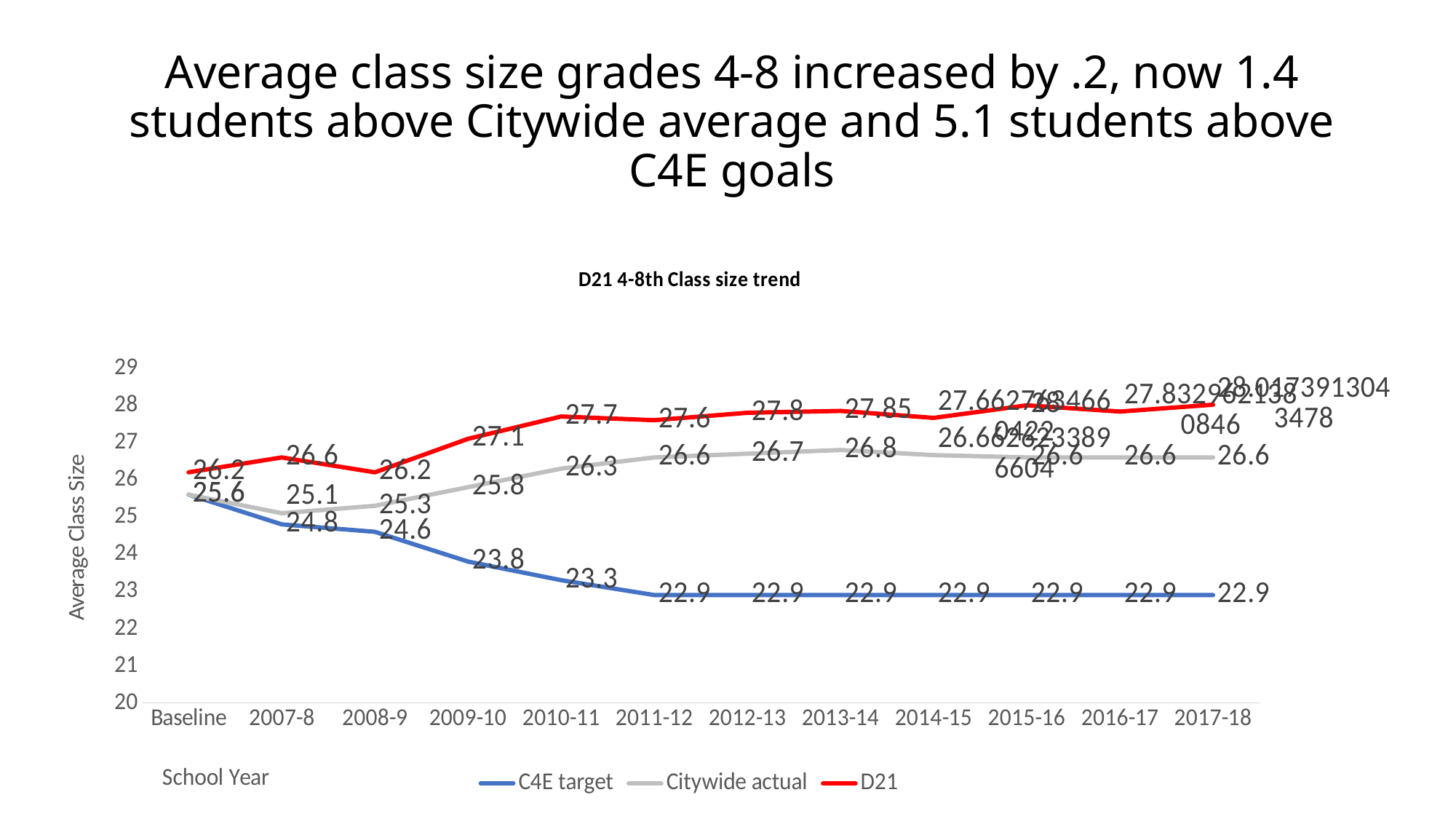
How many school-year categories are shown on the x axis? 12 What is the D21 value for 2007-8? 26.6 How many series does the legend list? 3 Is the D21 value for 2017-18 greater or less than 27? greater What is the C4E target value for 2009-10? 23.8 Which series has the highest value in 2011-12? D21 What is the difference between the D21 value and the C4E target value in 2012-13? 4.9 What is the D21 value for 2010-11? 27.7 What is the Citywide actual value for 2013-14? 26.8 What type of chart is shown on the slide? line chart Does the C4E target line rise or fall from Baseline to 2011-12? fall Which is larger in 2008-9, the Citywide actual value or the C4E target value? Citywide actual